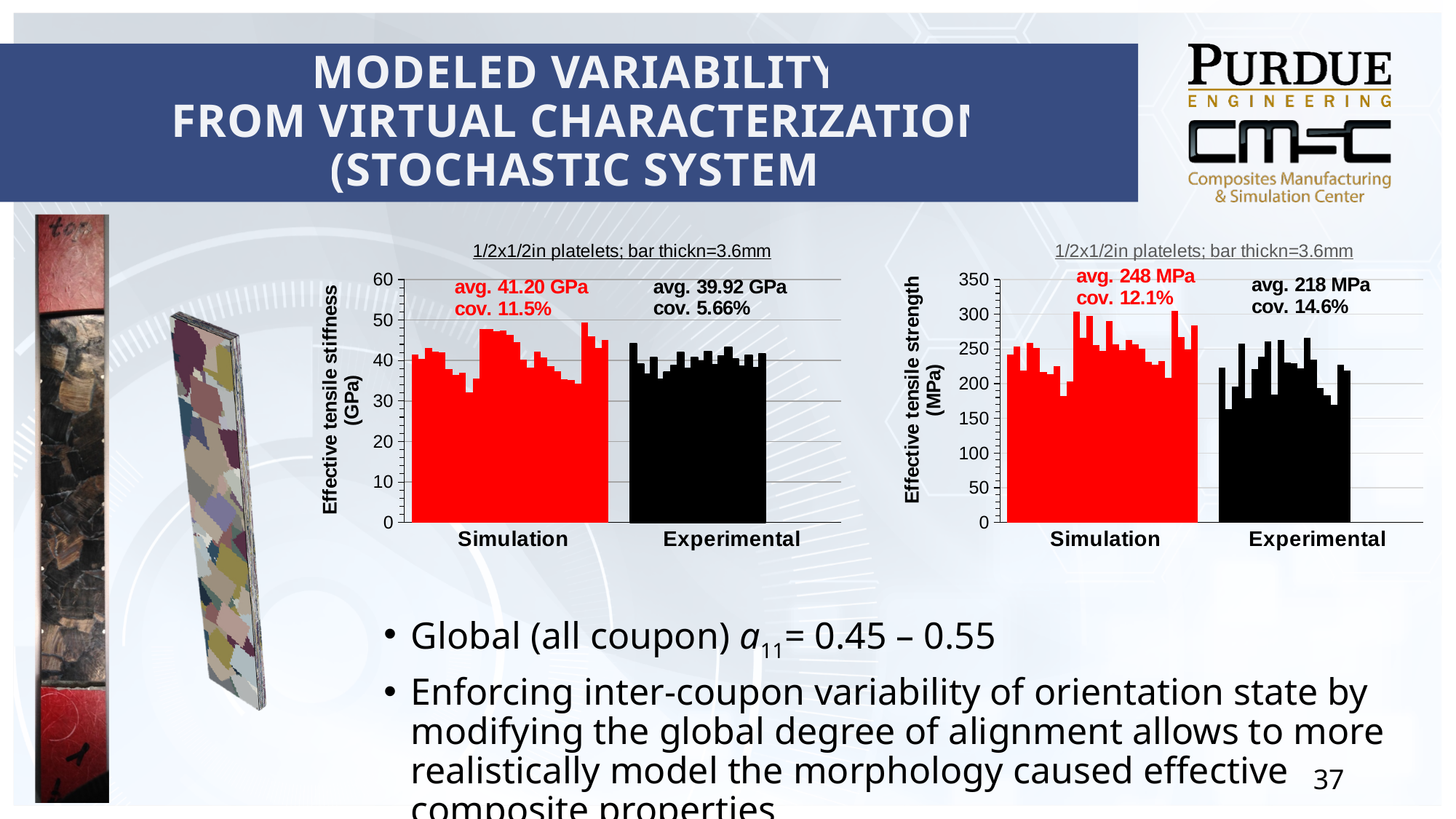
How many groups of bars are shown on the left chart (Effective tensile stiffness)? 2 On the right chart (Effective tensile strength), which group has the higher printed coefficient of variation, Simulation or Experimental? Experimental What kind of chart is the left chart (Effective tensile stiffness)? bar chart On the right chart (Effective tensile strength), what is the average value printed for the Simulation group? 248 MPa On the left chart (Effective tensile stiffness), what is the average value printed for the Experimental group? 39.92 GPa On the left chart (Effective tensile stiffness), what is the average value printed for the Simulation group? 41.20 GPa On the right chart (Effective tensile strength), what coefficient of variation is printed for the Experimental group? 14.6% On the right chart (Effective tensile strength), what colour are the Simulation bars? red On the left chart (Effective tensile stiffness), which group has the higher printed average, Simulation or Experimental? Simulation On the left chart (Effective tensile stiffness), what coefficient of variation is printed for the Experimental group? 5.66% On the right chart (Effective tensile strength), what is the difference between the printed Simulation average and the printed Experimental average? 30 MPa On the right chart (Effective tensile strength), are the Experimental bars greater or less than 300? less